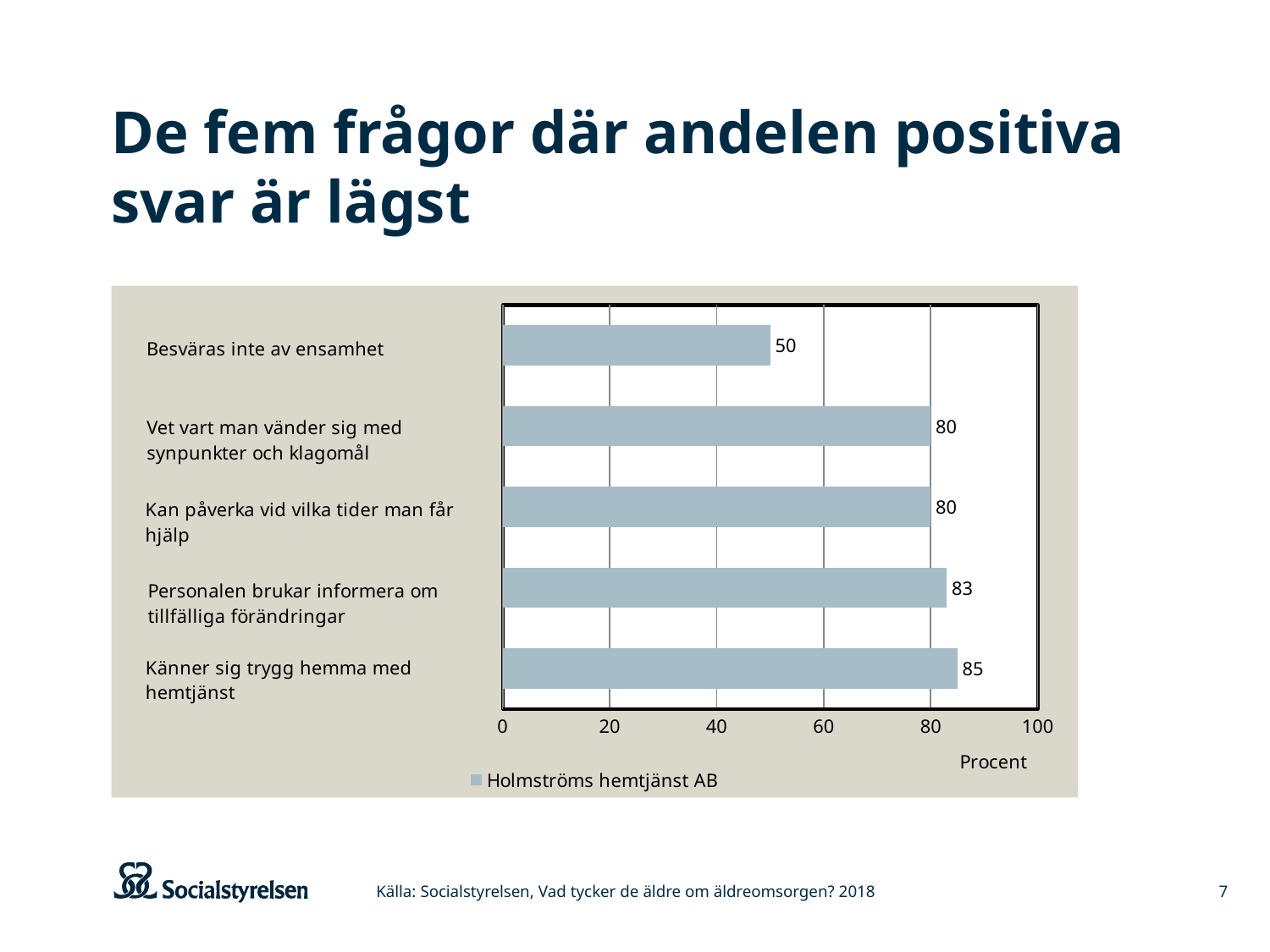
What is the value for "Personalen brukar informera om tillfälliga förändringar"? 83 Which category has the highest value? Känner sig trygg hemma med hemtjänst What is the value for "Besväras inte av ensamhet"? 50 What is the value for "Kan påverka vid vilka tider man får hjälp"? 80 What is the difference between the values for "Känner sig trygg hemma med hemtjänst" and "Besväras inte av ensamhet"? 35 Which category has the lowest value? Besväras inte av ensamhet What kind of chart is shown on the slide? bar chart What is the value for "Känner sig trygg hemma med hemtjänst"? 85 How many categories are shown in the chart? 5 What series name does the legend show? Holmströms hemtjänst AB Which is larger: the value for "Personalen brukar informera om tillfälliga förändringar" or the value for "Vet vart man vänder sig med synpunkter och klagomål"? Personalen brukar informera om tillfälliga förändringar Is the value for "Besväras inte av ensamhet" greater or less than 60? less